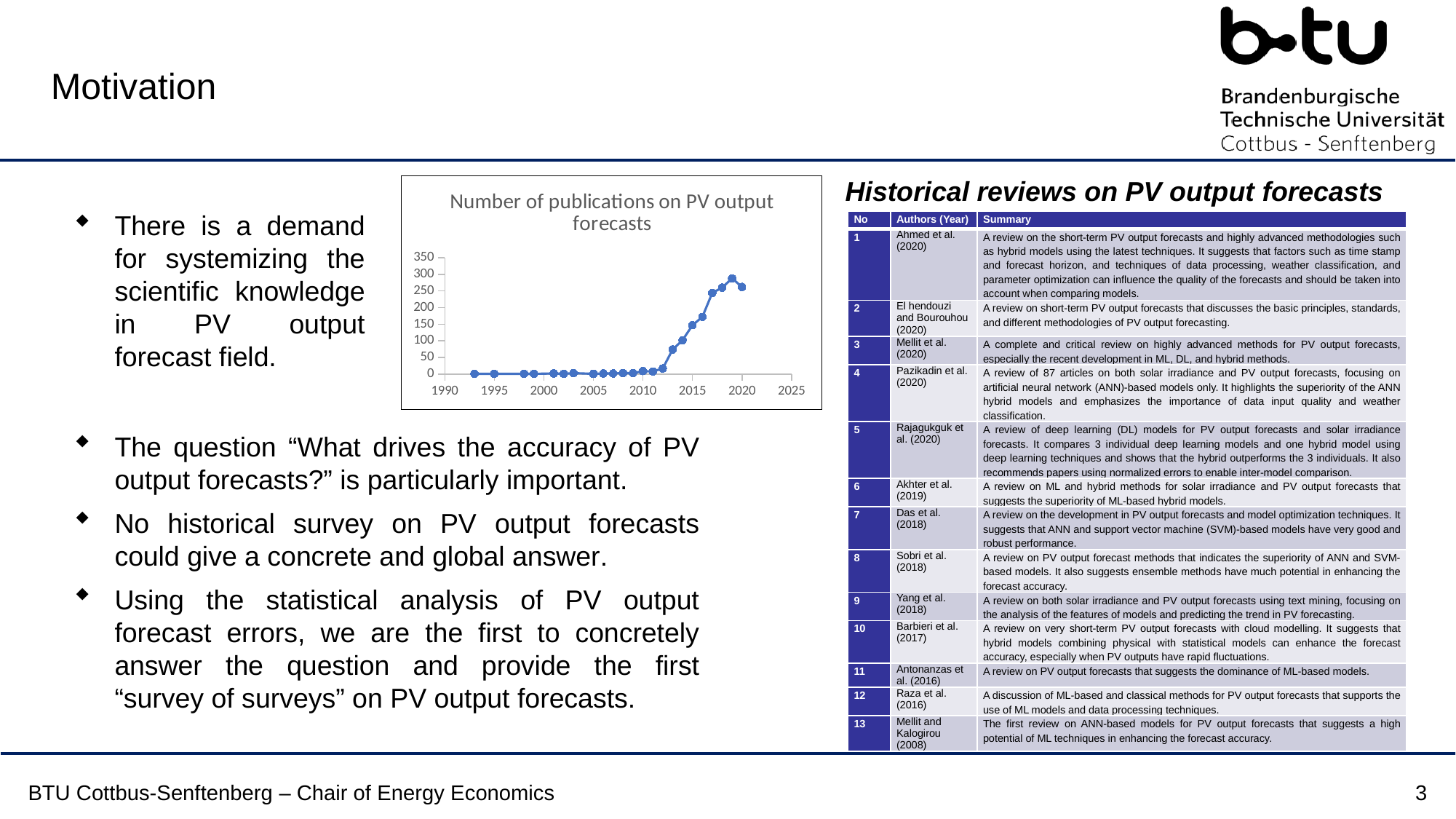
Is the value for 2018 greater or less than 200? greater Is the value for 2012 greater or less than 50? less Around which year does the chart reach its highest value? 2019 Is the value for 2019 greater or less than 250? greater Do the values in the chart generally rise or fall between 2010 and 2019? rise Which is larger, the value for 2019 or the value for 2012? 2019 What is the title of the chart on the slide? Number of publications on PV output forecasts What kind of chart is shown on the slide? line chart What is the highest tick value shown on the vertical axis of the chart? 350